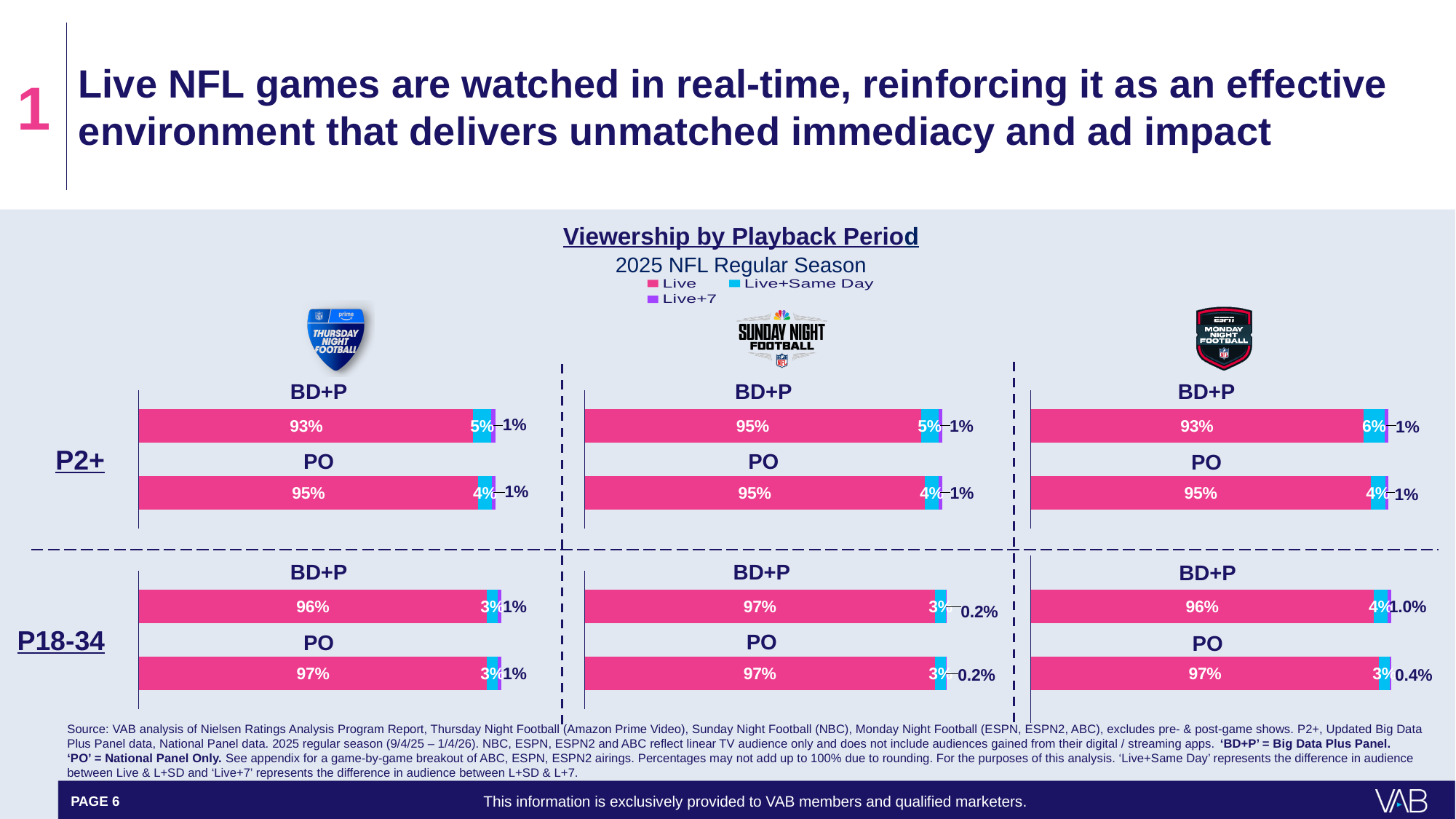
What kind of chart is used to show Viewership by Playback Period? Stacked bar chart What is the Live share for Thursday Night Football among P2+ on the BD+P bar? 93% What is the difference between the Live share on the PO bar and the BD+P bar for Thursday Night Football among P2+? 2% How many series does the legend list? 3 What is the Live+7 share for Sunday Night Football among P18-34 on the PO bar? 0.2% What season does the chart subtitle say the data covers? 2025 NFL Regular Season What is the difference between the Live+Same Day share for Monday Night Football and Thursday Night Football among P2+ on the BD+P bars? 1% Among the P2+ BD+P bars, which program has the highest Live+Same Day share? Monday Night Football What is the Live+Same Day share for Monday Night Football among P2+ on the BD+P bar? 6% What is the Live+7 share for Monday Night Football among P18-34 on the PO bar? 0.4% What is the Live share for Sunday Night Football among P18-34 on the BD+P bar? 97% For Monday Night Football among P18-34, is the Live share larger on the BD+P bar or the PO bar? PO